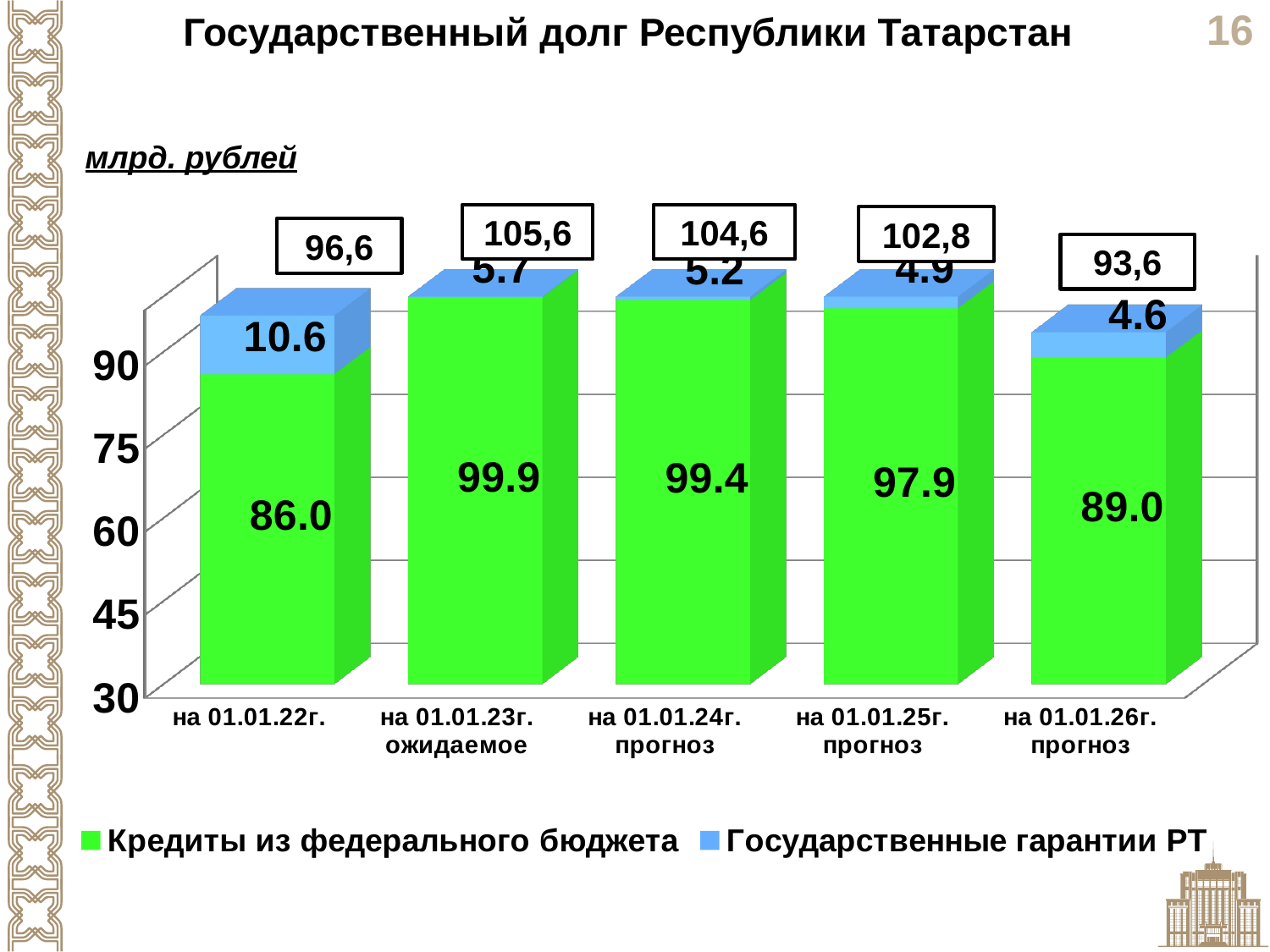
What is the total state debt shown above the bar for на 01.01.23г. ожидаемое? 105,6 Which is larger: Государственные гарантии РТ for на 01.01.22г. or for на 01.01.24г. прогноз? на 01.01.22г. What is the value of Кредиты из федерального бюджета for на 01.01.22г.? 86.0 How many series does the legend list? 2 What unit is stated for the values on the chart? млрд. рублей What is the value of Государственные гарантии РТ for на 01.01.26г. прогноз? 4.6 How many categories (dates) are shown on the x axis? 5 Is the value of Кредиты из федерального бюджета for на 01.01.25г. прогноз greater or less than 90? greater What kind of chart is shown on the slide? stacked bar chart What is the difference between the Кредиты из федерального бюджета values for на 01.01.23г. ожидаемое and на 01.01.22г.? 13.9 Which category has the highest value for Кредиты из федерального бюджета? на 01.01.23г. ожидаемое Which category has the lowest value for Государственные гарантии РТ? на 01.01.26г. прогноз